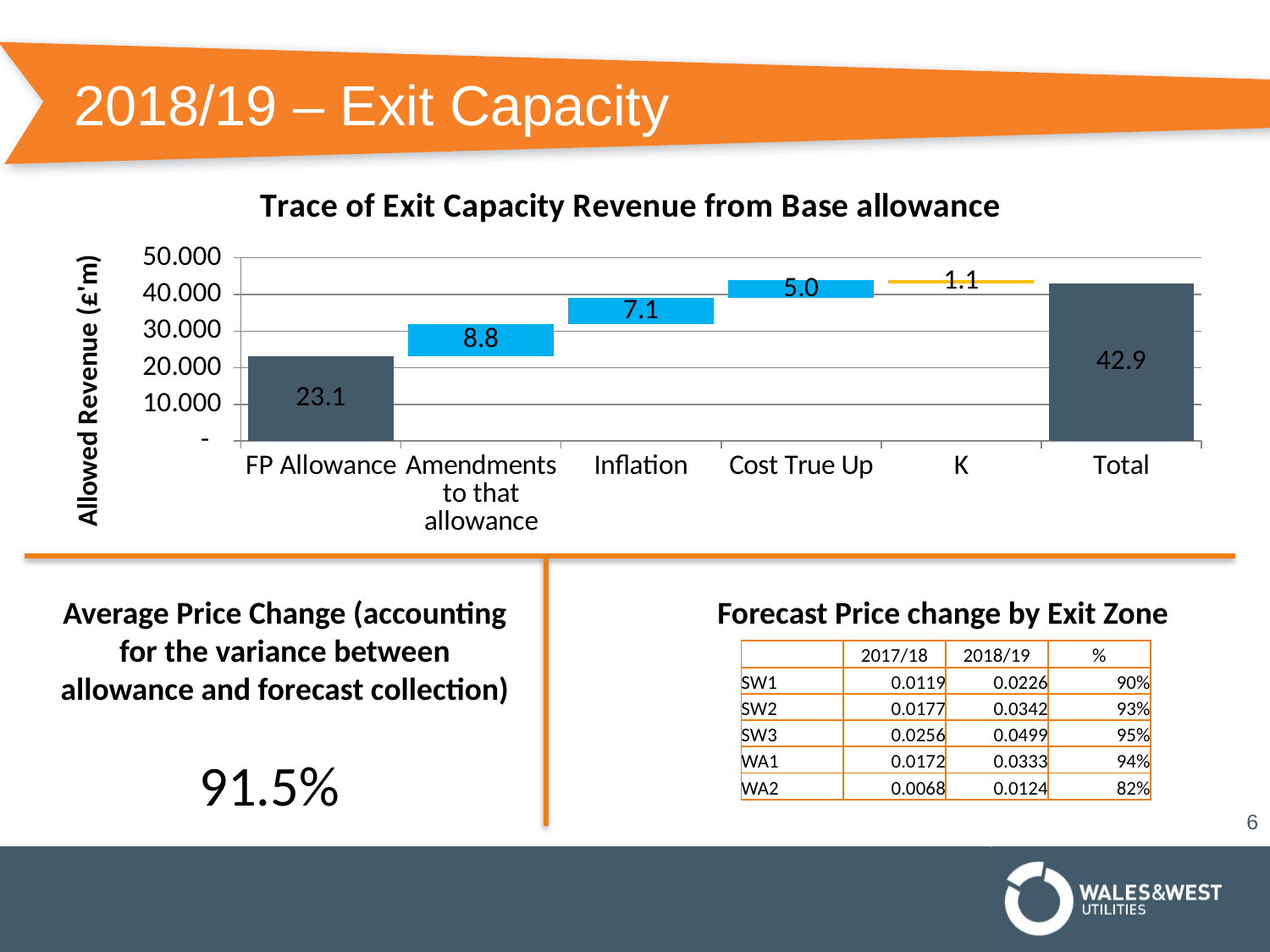
What is the value shown for Total in the chart? 42.9 What is the title of the chart on the slide? Trace of Exit Capacity Revenue from Base allowance What is the value shown for Inflation in the chart? 7.1 What is the value shown for K in the chart? 1.1 What is the difference between the values for Amendments to that allowance and Inflation? 1.7 How many categories are shown on the x axis of the chart? 6 What is the value shown for FP Allowance in the chart? 23.1 Which category in the chart has the largest value? Total What is the value shown for Cost True Up in the chart? 5.0 Which category in the chart has the smallest value? K What kind of chart is shown on the slide? Bar chart Which is larger, the value for Inflation or the value for Cost True Up? Inflation